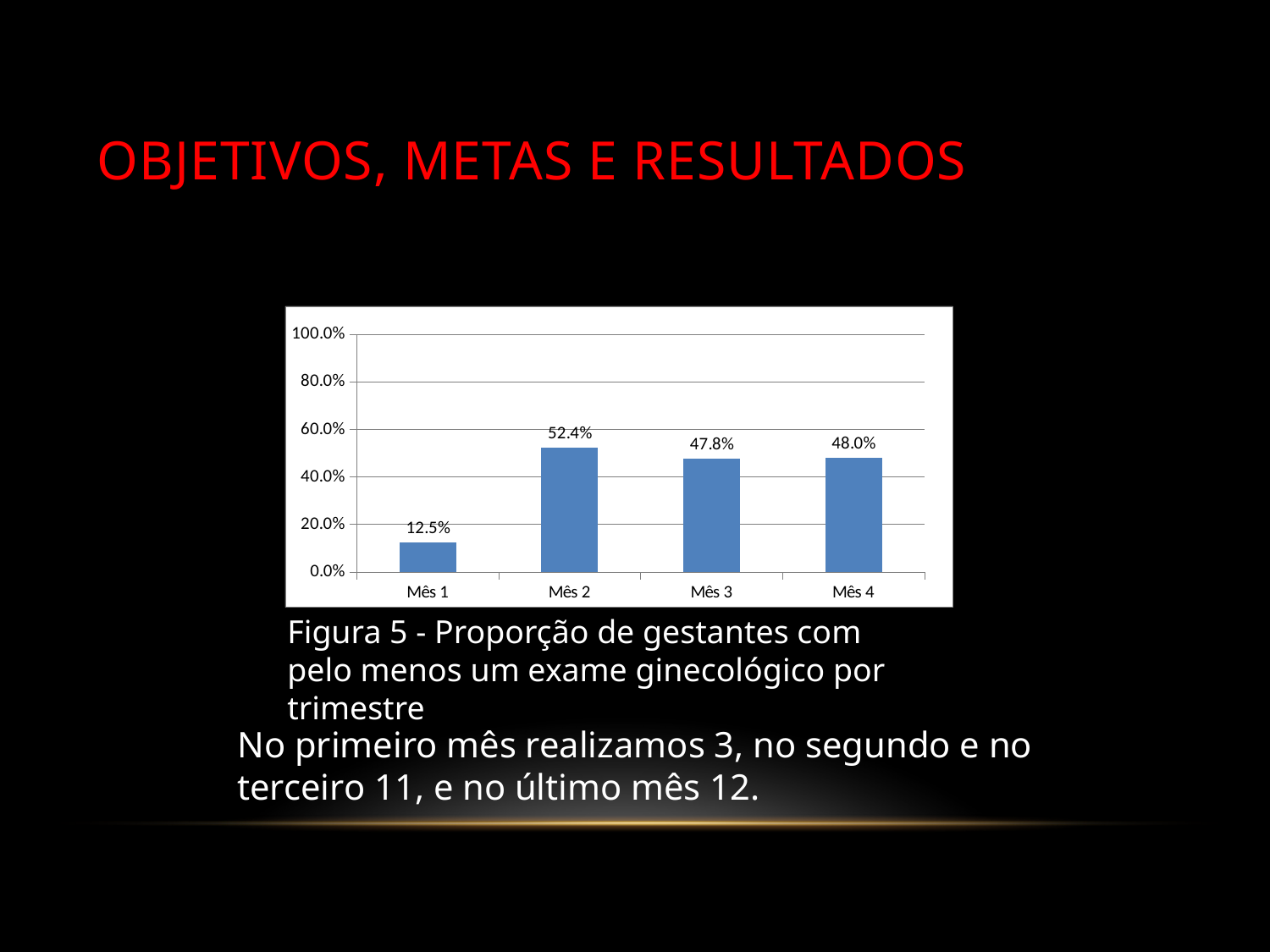
What is the value for Mês 1? 12.5% What is the caption given for the chart (Figura 5)? Proporção de gestantes com pelo menos um exame ginecológico por trimestre What is the difference between the values for Mês 2 and Mês 1? 39.9% Which is larger, the value for Mês 2 or the value for Mês 3? Mês 2 How many months are shown on the x axis? 4 What is the value for Mês 4? 48.0% Which month has the lowest value? Mês 1 What is the value for Mês 2? 52.4% What is the value for Mês 3? 47.8% What kind of chart is shown on the slide? bar chart Which month has the highest value? Mês 2 Is the value for Mês 3 greater or less than 60.0%? less